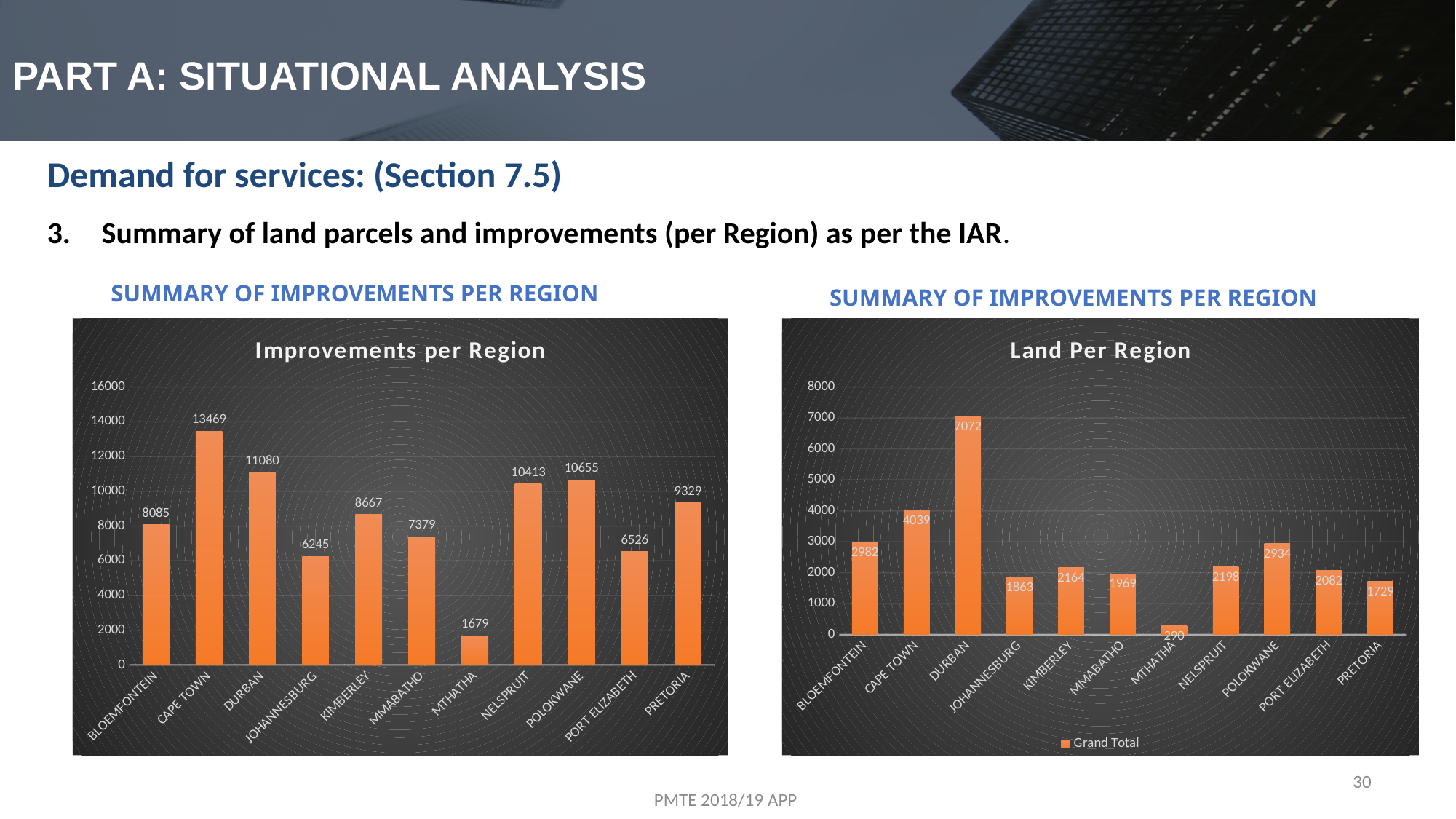
In the 'Land Per Region' chart, which is larger, CAPE TOWN or POLOKWANE? CAPE TOWN In the 'Land Per Region' chart, what is the value for DURBAN? 7072 In the 'Improvements per Region' chart, how many regions are shown? 11 In the 'Improvements per Region' chart, which region has the lowest value? MTHATHA What type of chart is the 'Land Per Region' chart? Bar chart In the 'Improvements per Region' chart, what is the value for CAPE TOWN? 13469 In the 'Improvements per Region' chart, what is the difference between DURBAN and JOHANNESBURG? 4835 In the 'Land Per Region' chart, what series name does the legend show? Grand Total In the 'Improvements per Region' chart, which region has the highest value? CAPE TOWN In the 'Improvements per Region' chart, what is the value for PORT ELIZABETH? 6526 In the 'Land Per Region' chart, which region has the lowest value? MTHATHA In the 'Land Per Region' chart, what is the difference between BLOEMFONTEIN and PRETORIA? 1253